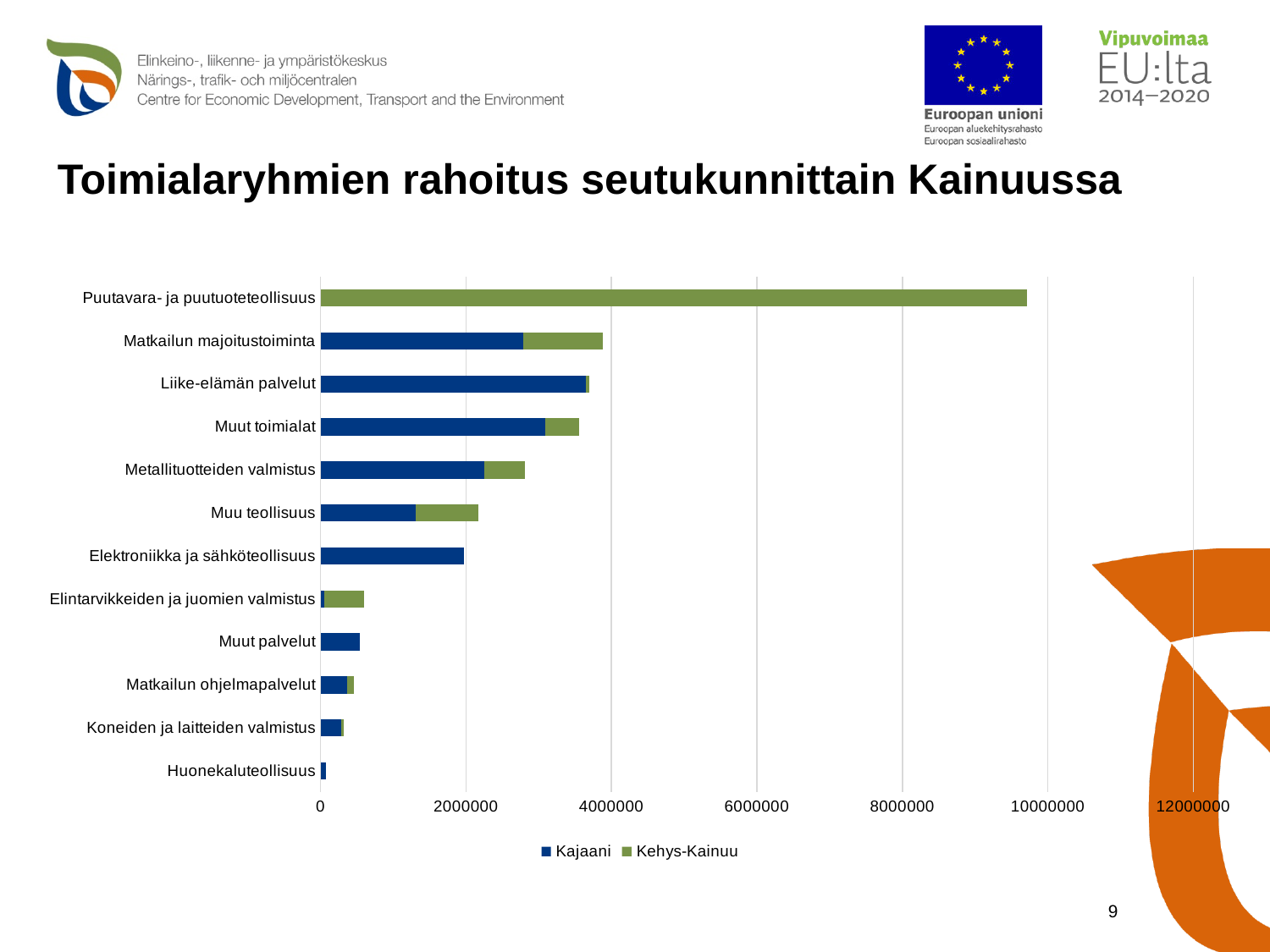
How many categories are plotted on the chart? 12 Is the total value for Puutavara- ja puutuoteteollisuus greater or less than 8000000? greater Which category has the longest total bar? Puutavara- ja puutuoteteollisuus How many series does the legend list? 2 Which has the larger Kajaani value, Liike-elämän palvelut or Matkailun majoitustoiminta? Liike-elämän palvelut What kind of chart is shown on the slide? Bar chart Do the total bar lengths increase or decrease from the top category to the bottom category? decrease Which has the larger total bar, Matkailun majoitustoiminta or Metallituotteiden valmistus? Matkailun majoitustoiminta What is the title of the chart slide? Toimialaryhmien rahoitus seutukunnittain Kainuussa Is the total value for Metallituotteiden valmistus greater or less than 2000000? greater Is the total value for Muut toimialat greater or less than 4000000? less Which category has the shortest total bar? Huonekaluteollisuus